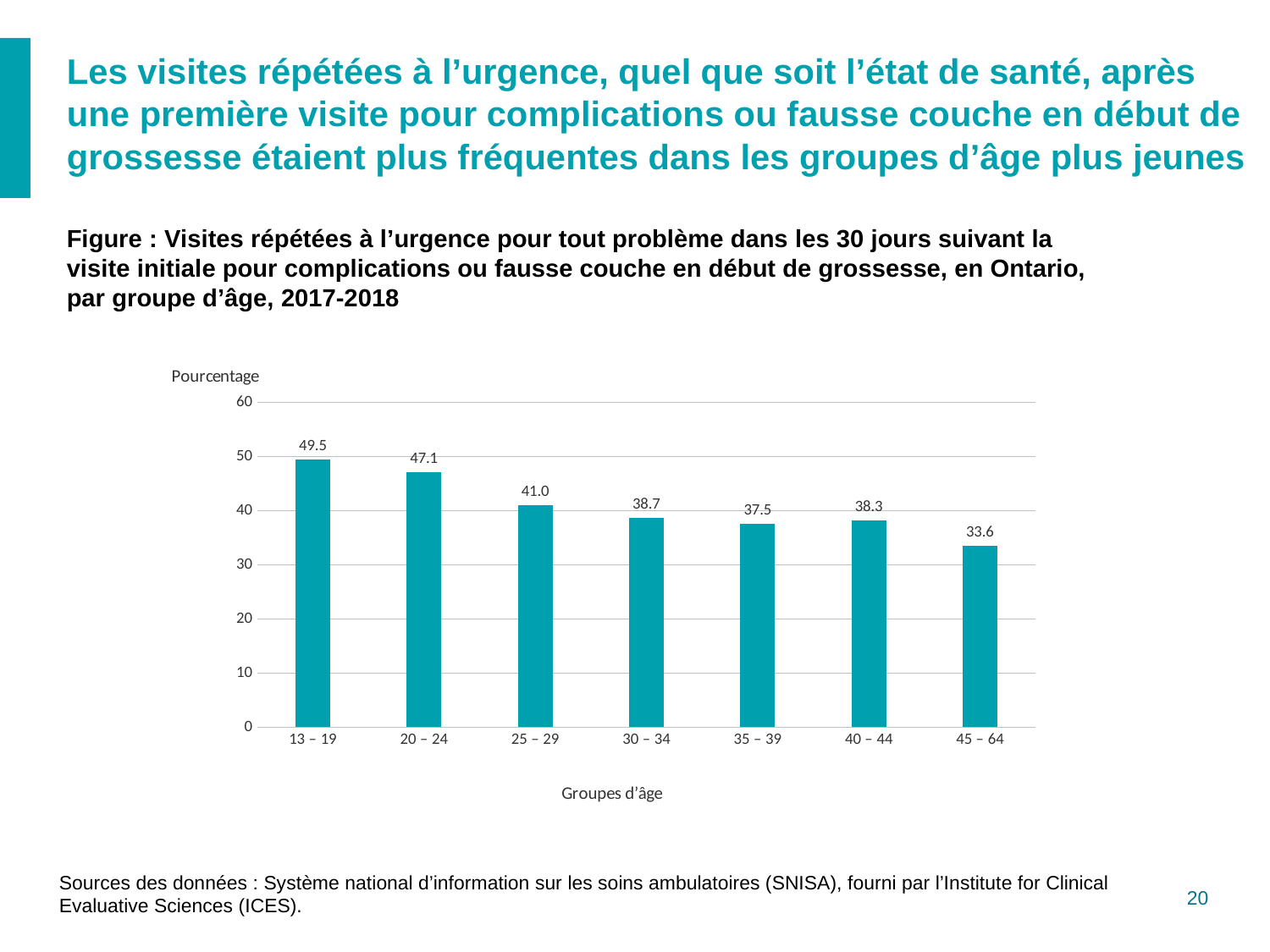
Which age group has the highest percentage? 13 – 19 What is the difference between the values for the 13 – 19 and 20 – 24 age groups? 2.4 What kind of chart is shown on the slide? Bar chart How many age groups are shown on the chart? 7 What is the value for the 45 – 64 age group? 33.6 Which age group has the lowest percentage? 45 – 64 What is the difference between the values for the 25 – 29 and 45 – 64 age groups? 7.4 What is the value for the 13 – 19 age group? 49.5 Is the value for the 25 – 29 age group greater or less than 40? greater Which is larger, the value for 35 – 39 or the value for 40 – 44? 40 – 44 What is the value for the 30 – 34 age group? 38.7 What is the label of the x axis? Groupes d’âge